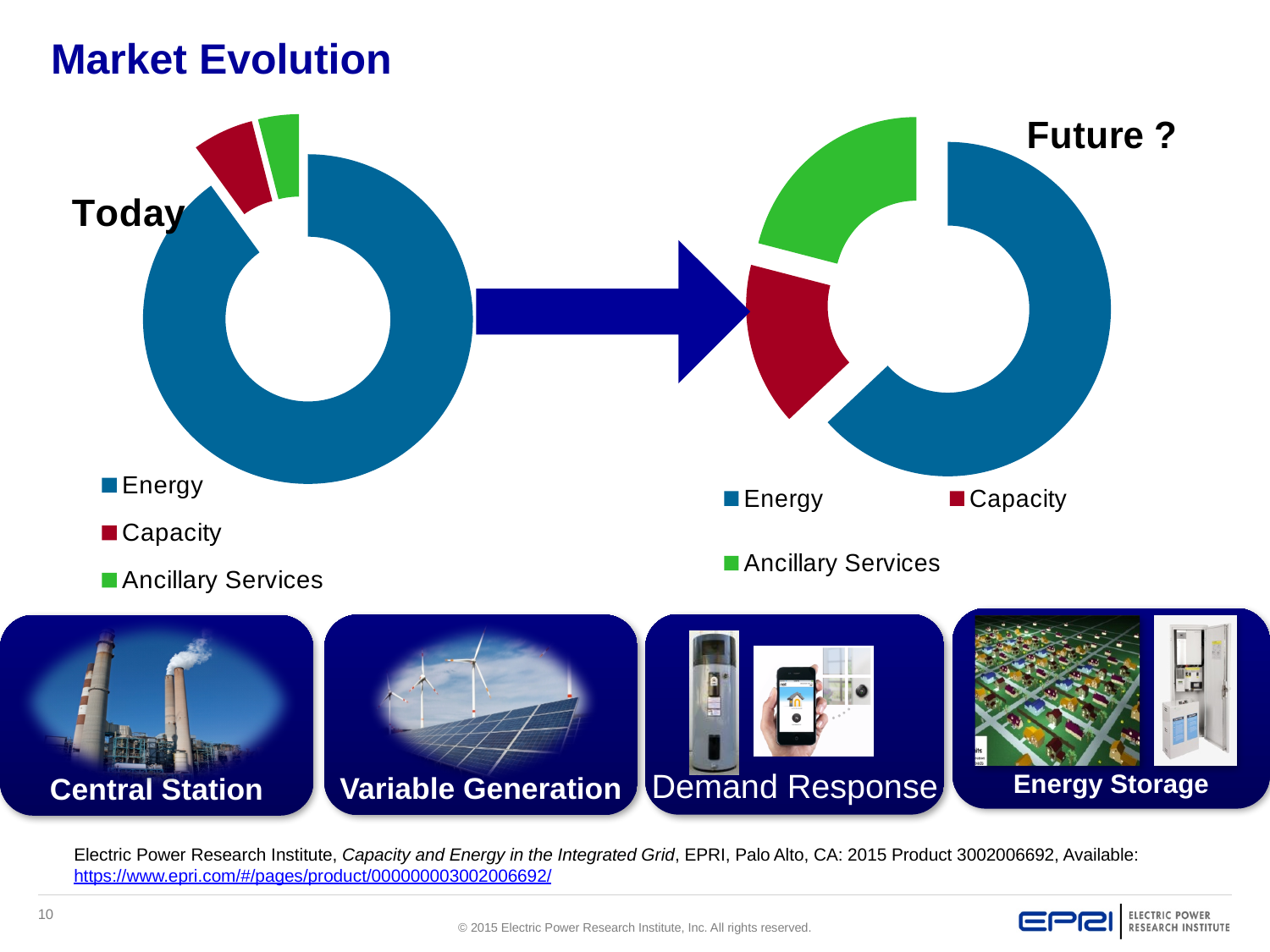
What kind of chart is the "Today" chart on the left? Doughnut chart In the "Future ?" chart, which colour represents Ancillary Services? Green In the "Today" chart, which slice is larger, Capacity or Ancillary Services? Capacity In the "Today" chart, which category has the largest slice? Energy In the "Today" chart, which category has the smallest slice? Ancillary Services In the "Future ?" chart, how many categories does the legend list? 3 In the "Future ?" chart, which slice is larger, Energy or Capacity? Energy In the "Future ?" chart, which category has the largest slice? Energy In the "Today" chart, how many categories does the legend list? 3 In the "Today" chart, which colour represents Capacity? Red What kind of chart is the "Future ?" chart on the right? Doughnut chart